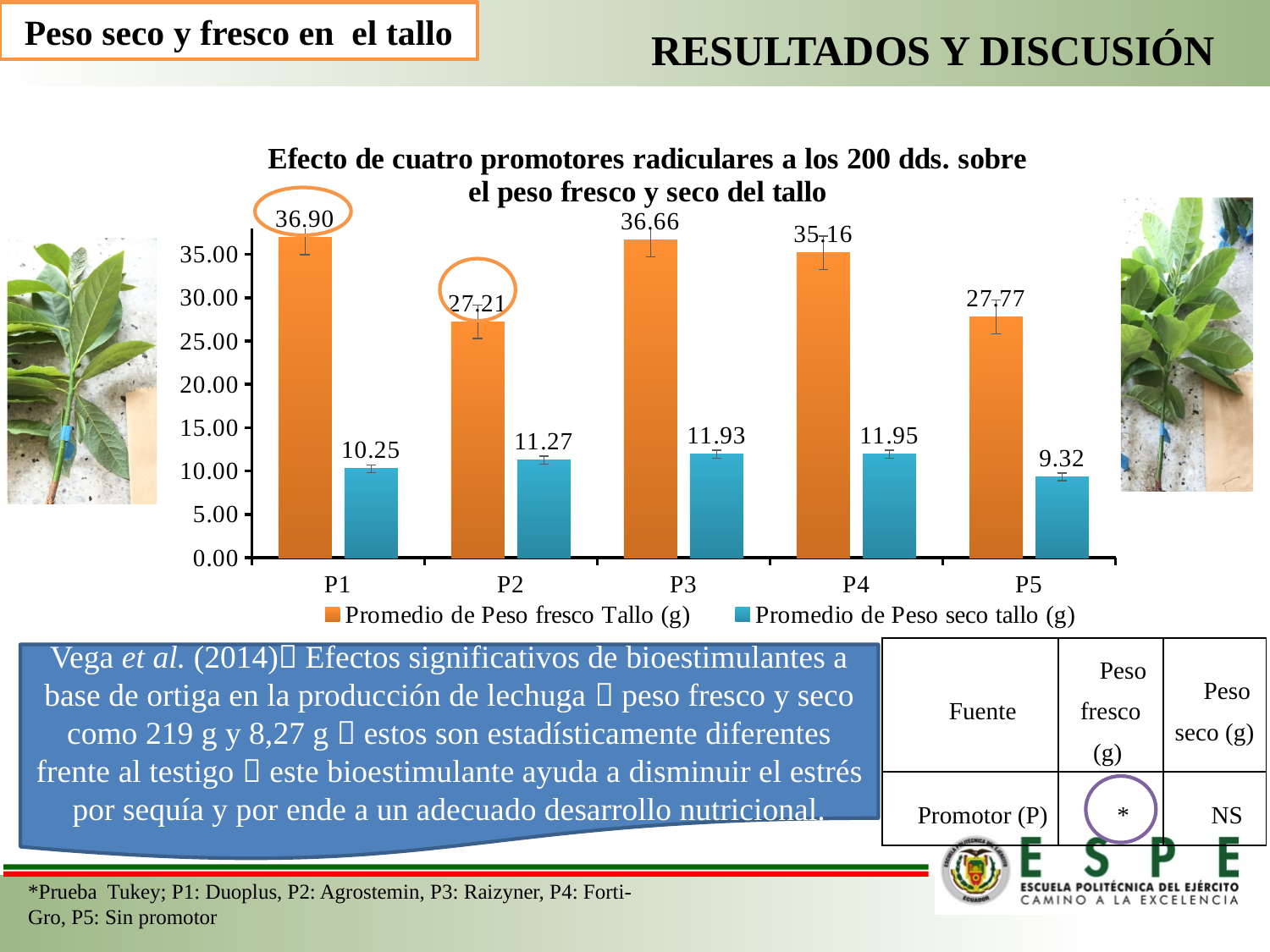
Is the Promedio de Peso fresco Tallo (g) for P5 greater or less than 25.00? greater How many promoter categories are shown on the x axis? 5 What is the value of Promedio de Peso fresco Tallo (g) for P1? 36.90 Which promoter has the lowest Promedio de Peso seco tallo (g)? P5 What type of chart is shown on the slide? bar chart What is the value of Promedio de Peso fresco Tallo (g) for P4? 35.16 How many series does the legend list? 2 What is the difference between the Promedio de Peso seco tallo (g) for P4 and for P5? 2.63 What is the difference between the Promedio de Peso fresco Tallo (g) for P3 and for P2? 9.45 What is the value of Promedio de Peso seco tallo (g) for P5? 9.32 Which promoter has the highest Promedio de Peso fresco Tallo (g)? P1 Which is larger, the Promedio de Peso fresco Tallo (g) for P2 or for P4? P4